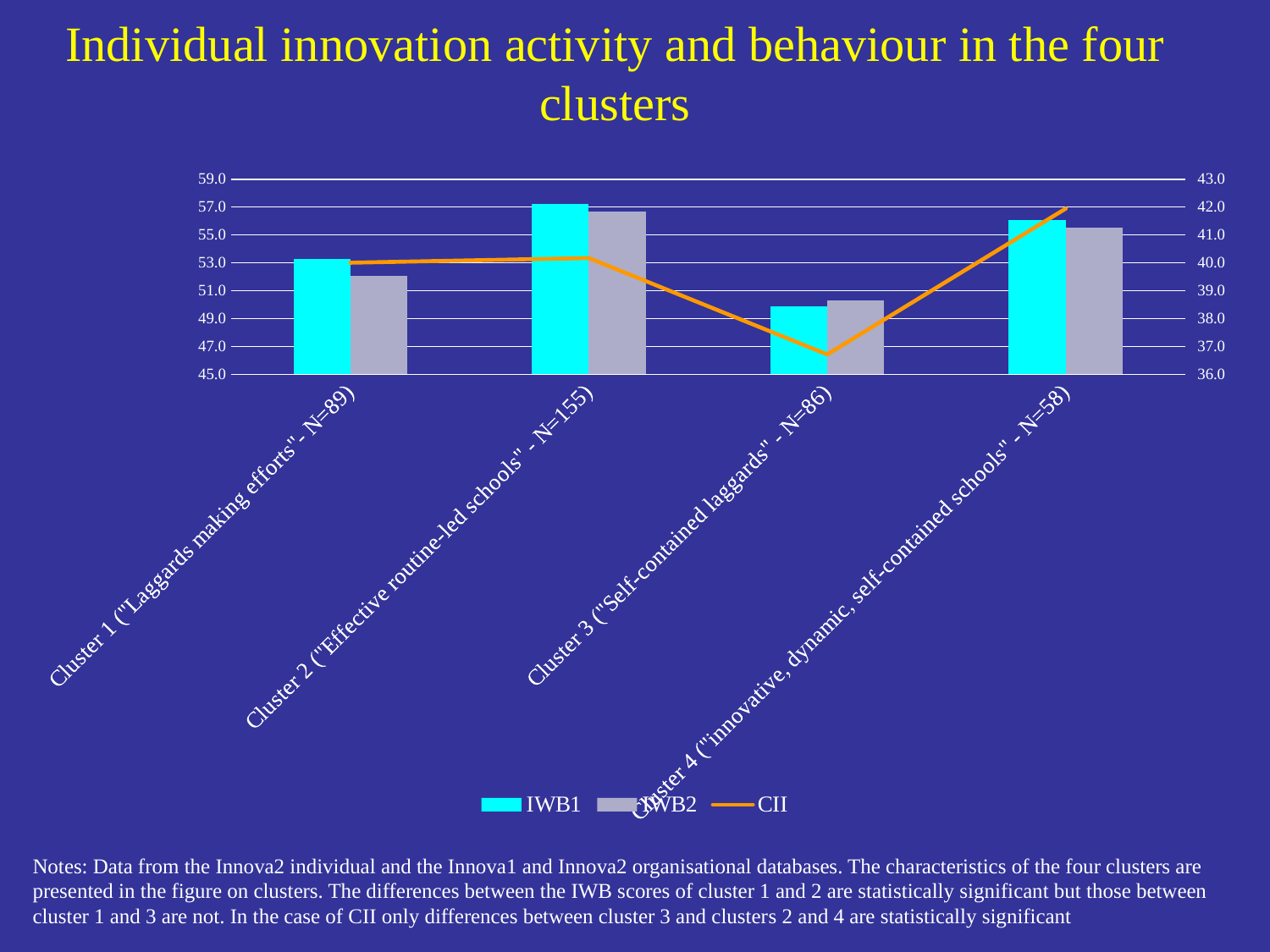
Which cluster has the highest IWB1 value? Cluster 2 ("Effective routine-led schools" - N=155) Which cluster has the highest CII value? Cluster 4 ("innovative, dynamic, self-contained schools" - N=58) How many clusters are plotted along the x axis? 4 How many series does the legend list? 3 Is the IWB1 value for Cluster 3 greater or less than 51.0? less What kind of chart is shown on the slide? A combined bar and line chart Which is larger for Cluster 1, the IWB1 value or the IWB2 value? IWB1 Which cluster has the lowest IWB1 value? Cluster 3 ("Self-contained laggards" - N=86) Is the CII value for Cluster 4 greater or less than 41.0? greater Is the IWB2 value for Cluster 1 greater or less than 51.0? greater Which cluster has the lowest CII value? Cluster 3 ("Self-contained laggards" - N=86) Which series is plotted as an orange line? CII